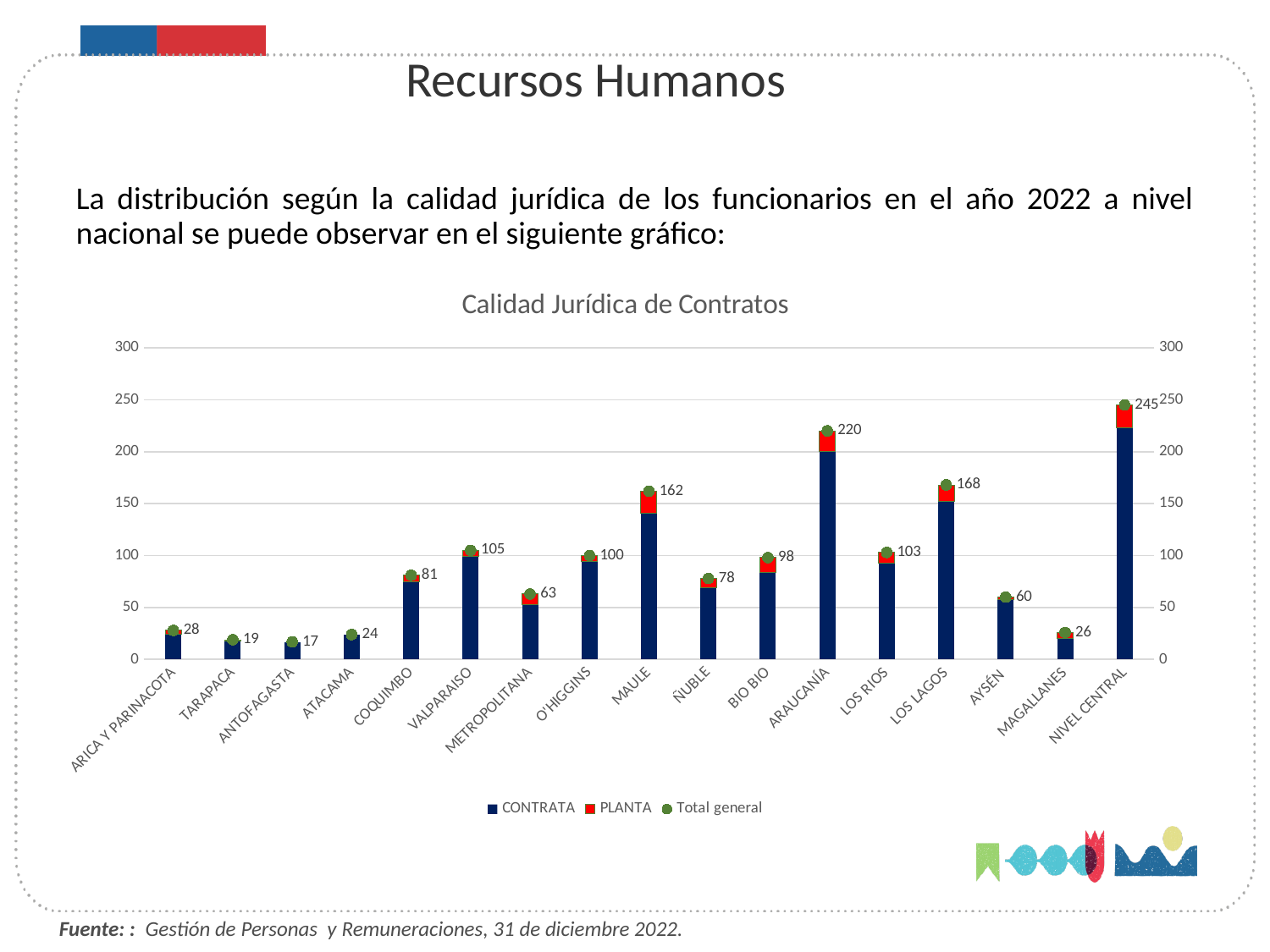
Which has a larger Total general, LOS LAGOS or MAULE? LOS LAGOS What kind of chart is shown? Bar chart What is the title of the chart? Calidad Jurídica de Contratos Is the CONTRATA value for ARAUCANÍA greater or less than 150? greater Which region has the lowest Total general? ANTOFAGASTA What is the Total general value for MAULE? 162 What is the Total general value for METROPOLITANA? 63 Which region has the highest Total general? NIVEL CENTRAL How many regions are shown on the x axis? 17 What is the Total general value for NIVEL CENTRAL? 245 What is the difference between the Total general for NIVEL CENTRAL and ARAUCANÍA? 25 How many series does the legend list? 3